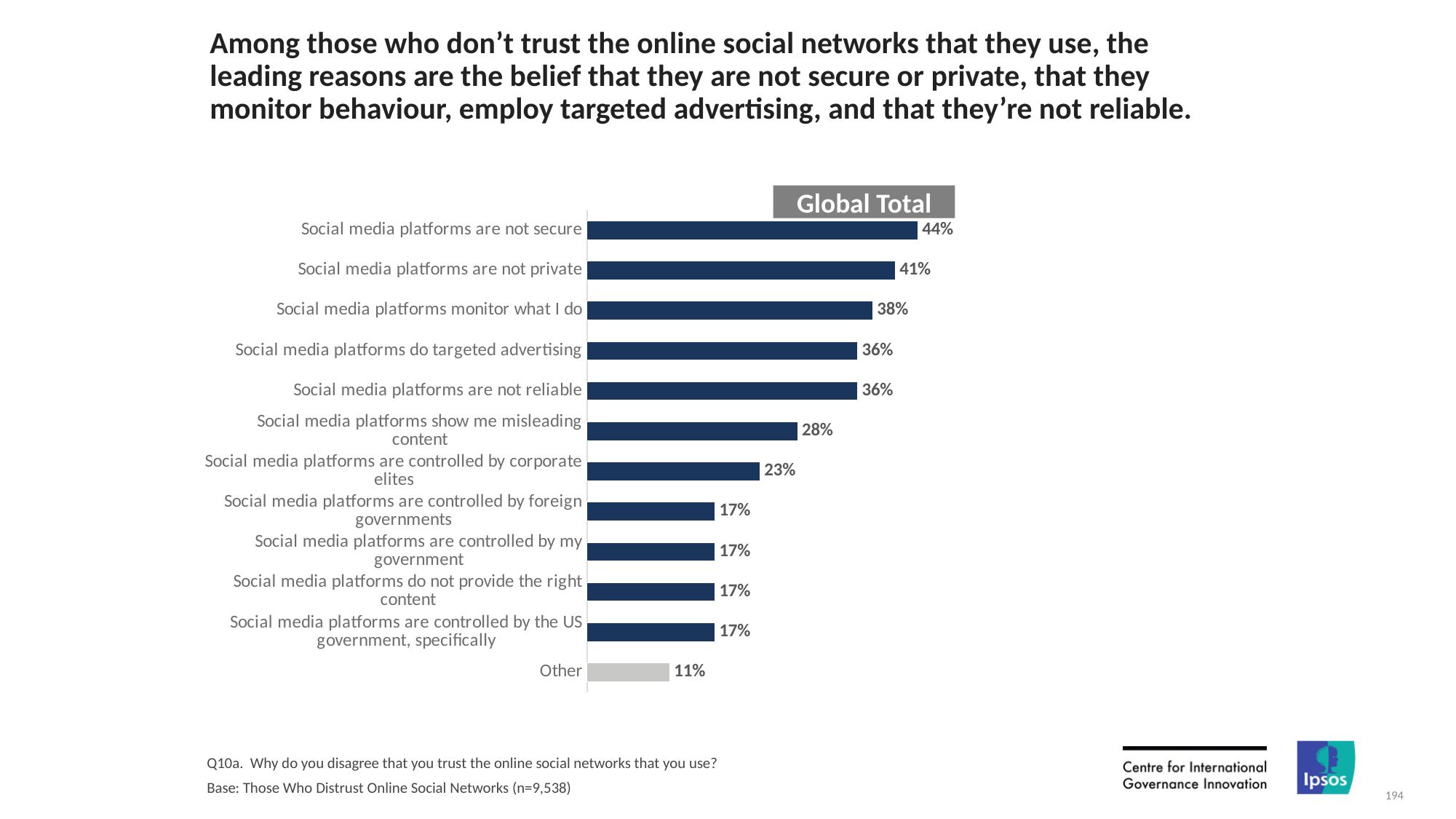
What is the value for 'Other'? 11% What is the difference between 'Social media platforms are not secure' and 'Social media platforms are not private'? 3% Which category has the lowest value on the chart? Other What type of chart is shown on the slide? Bar chart What is the value for 'Social media platforms monitor what I do'? 38% How many categories are shown on the chart? 12 What is the difference between 'Social media platforms show me misleading content' and 'Social media platforms are controlled by corporate elites'? 5% Which is larger: 'Social media platforms monitor what I do' or 'Social media platforms are controlled by corporate elites'? Social media platforms monitor what I do What is the label shown in the grey box above the bars? Global Total What percentage said social media platforms show me misleading content? 28% Which reason has the highest percentage? Social media platforms are not secure What percentage of respondents said social media platforms are not secure? 44%